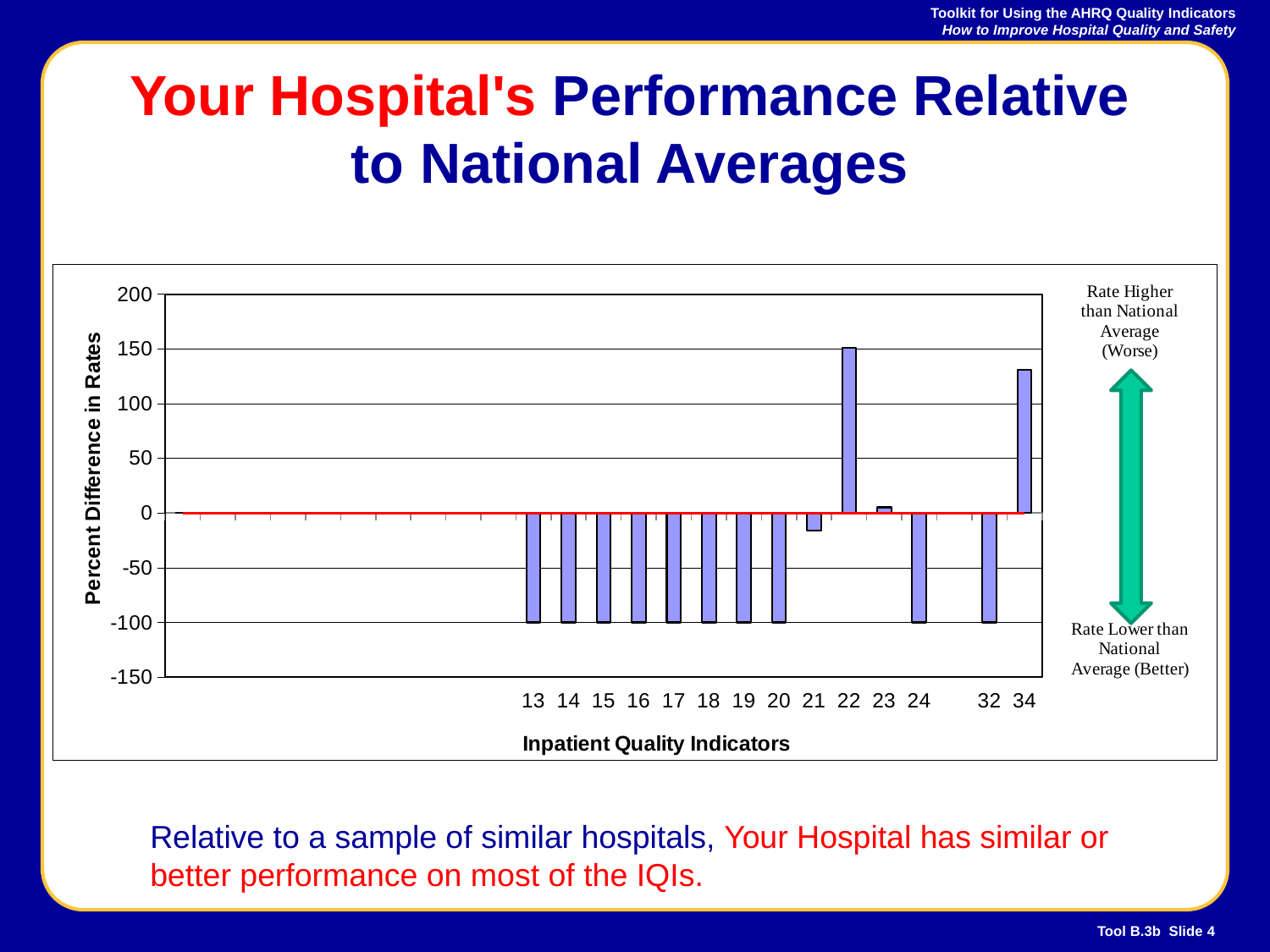
What is the title of the y axis? Percent Difference in Rates What kind of chart is shown on the slide? bar chart Is the value for IQI 34 greater or less than 100? greater What is the percent difference in rates for IQI 13? -100 What is the title of the x axis? Inpatient Quality Indicators Which has the larger percent difference in rates, IQI 22 or IQI 34? IQI 22 Which Inpatient Quality Indicator has the highest percent difference in rates? 22 Is the value for IQI 23 greater or less than 0? greater Is the value for IQI 21 greater or less than 0? less How many Inpatient Quality Indicators are labeled on the x axis? 14 Which has the larger percent difference in rates, IQI 21 or IQI 23? IQI 23